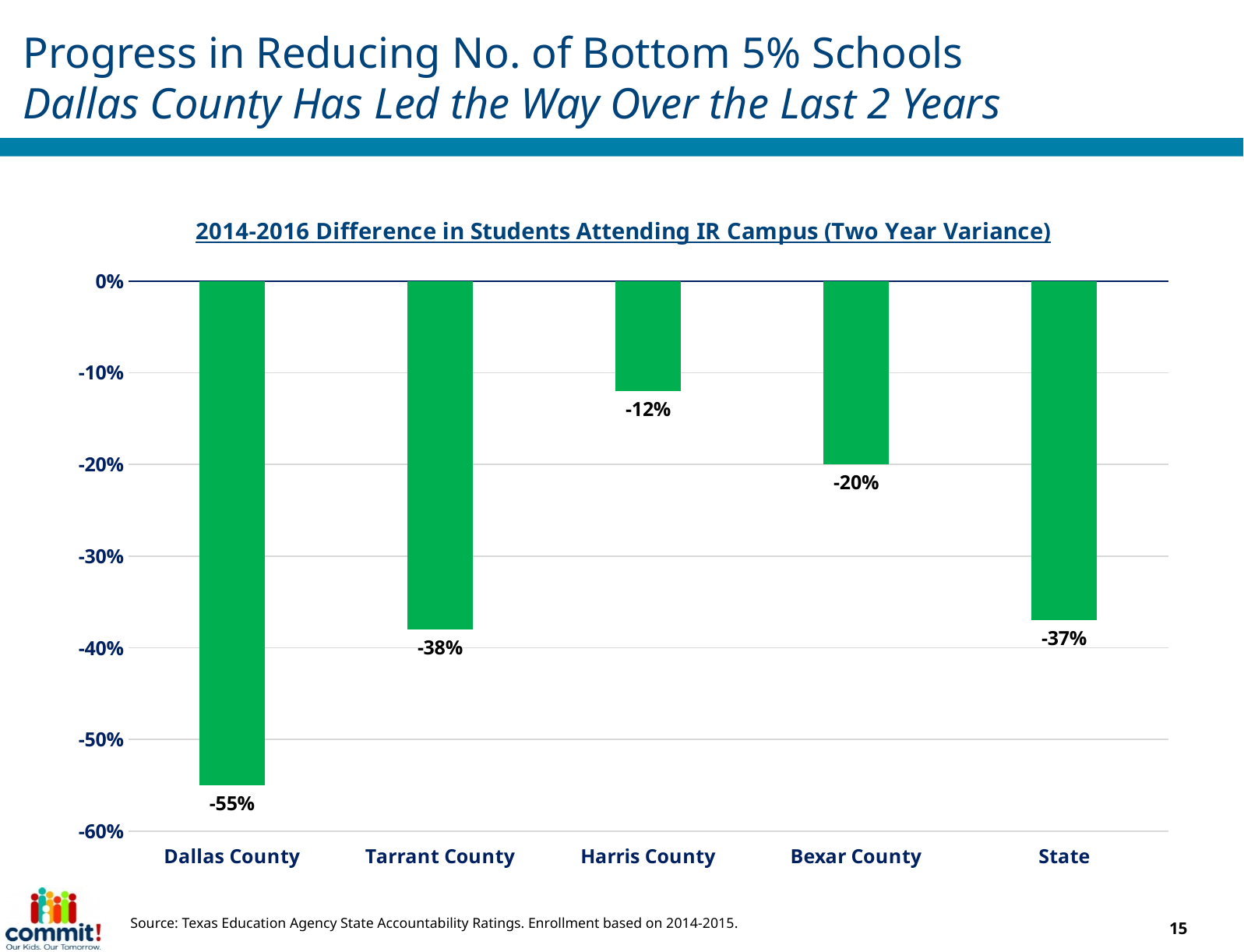
Which category shows the smallest decrease (the highest value)? Harris County What is the value shown for Harris County? -12% Which has a larger decrease, Tarrant County or State? Tarrant County What is the value shown for Bexar County? -20% Which category shows the largest decrease (the lowest value)? Dallas County How many categories are shown on the x axis? 5 By how many percentage points does the Bexar County value differ from the Harris County value? 8 percentage points What kind of chart is shown on the slide? Bar chart What is the value shown for Dallas County? -55% By how many percentage points does the Dallas County value differ from the Tarrant County value? 17 percentage points What is the value shown for Tarrant County? -38% What is the value shown for State? -37%